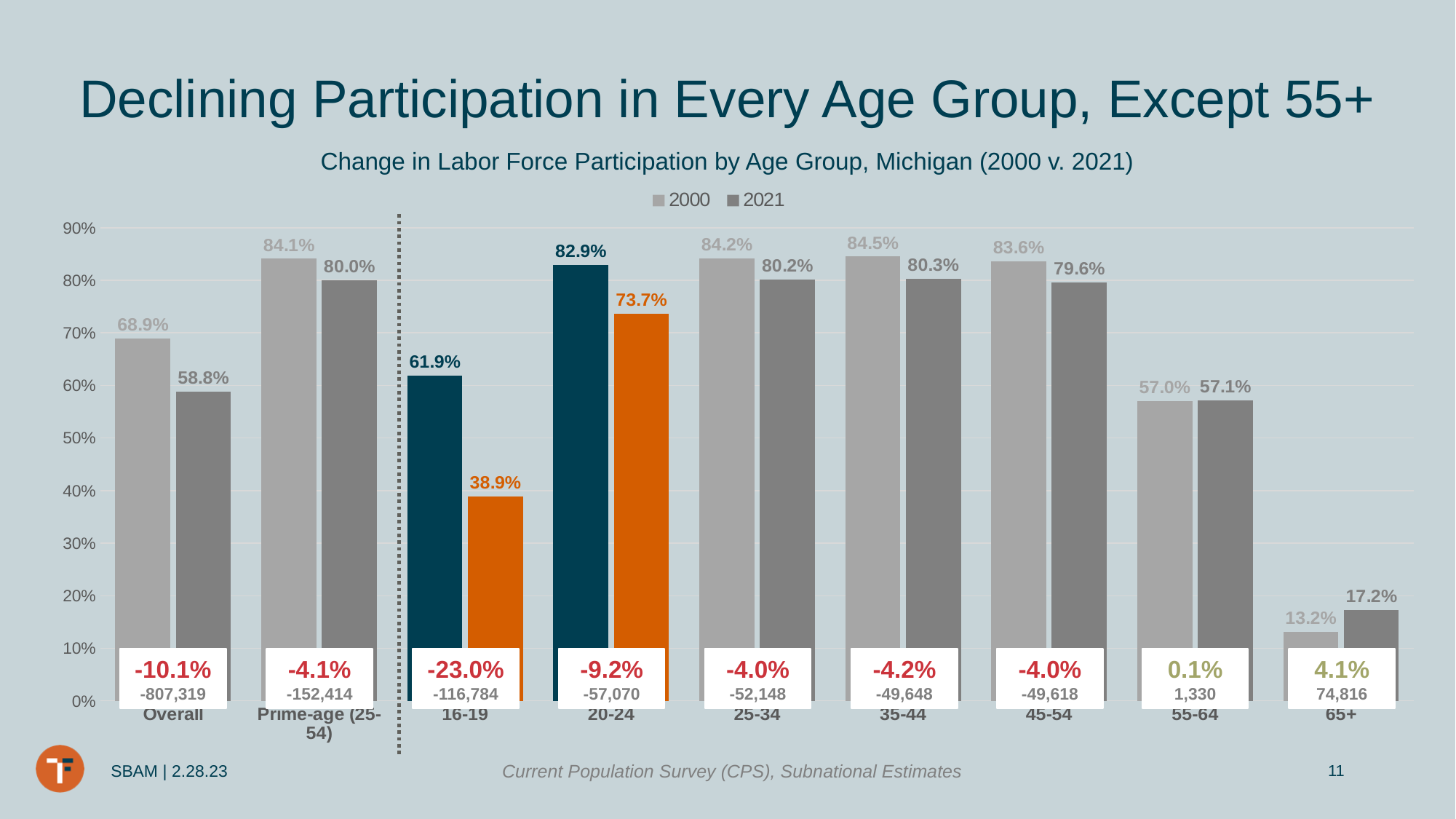
What was the labor force participation rate for the 65+ age group in 2021? 17.2% By how many percentage points did the participation rate for the 16-19 age group fall from 2000 to 2021? 23.0 percentage points Which age group had the lowest labor force participation rate in 2000? 65+ What is the difference between the 2000 and 2021 Overall participation rates? 10.1 percentage points How many series does the chart's legend list? 2 In 2021, which had a higher participation rate: the 20-24 age group or the 25-34 age group? 25-34 What was the Overall labor force participation rate in 2000? 68.9% Which category had the highest labor force participation rate in 2000? 35-44 How many categories are shown on the x axis of the chart? 9 What was the labor force participation rate for the 16-19 age group in 2021? 38.9% Is the 2021 participation rate for the 65+ age group greater or less than 20%? less What type of chart is shown on the slide? Bar chart